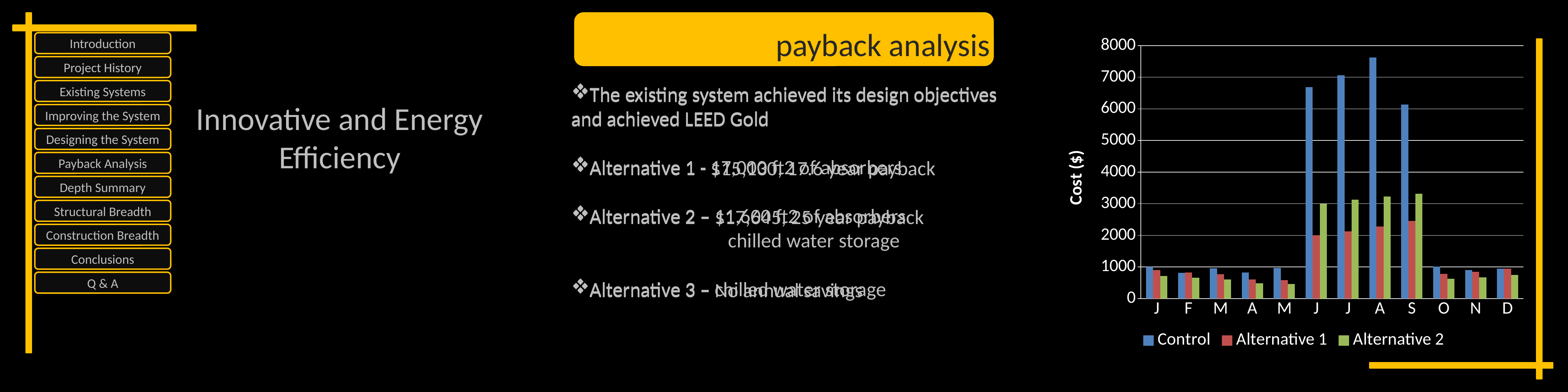
How many categories (months) are shown along the x axis of the chart? 12 How many series does the chart's legend list? 3 Is the Alternative 2 value for the category labelled S (September) greater or less than 3000? greater Is the Control value for the first J category (January) greater or less than 2000? less Is the Control value for the category labelled A (August) greater or less than 7000? greater In the category labelled A (August), which is larger: the Control value or the Alternative 2 value? Control What is the title of the chart's vertical axis? Cost ($) In the category labelled S (September), which is larger: the Alternative 1 value or the Alternative 2 value? Alternative 2 For which month category is the Control value highest? A (August) What kind of chart is shown on the slide? bar chart What are the three series named in the chart's legend? Control, Alternative 1, Alternative 2